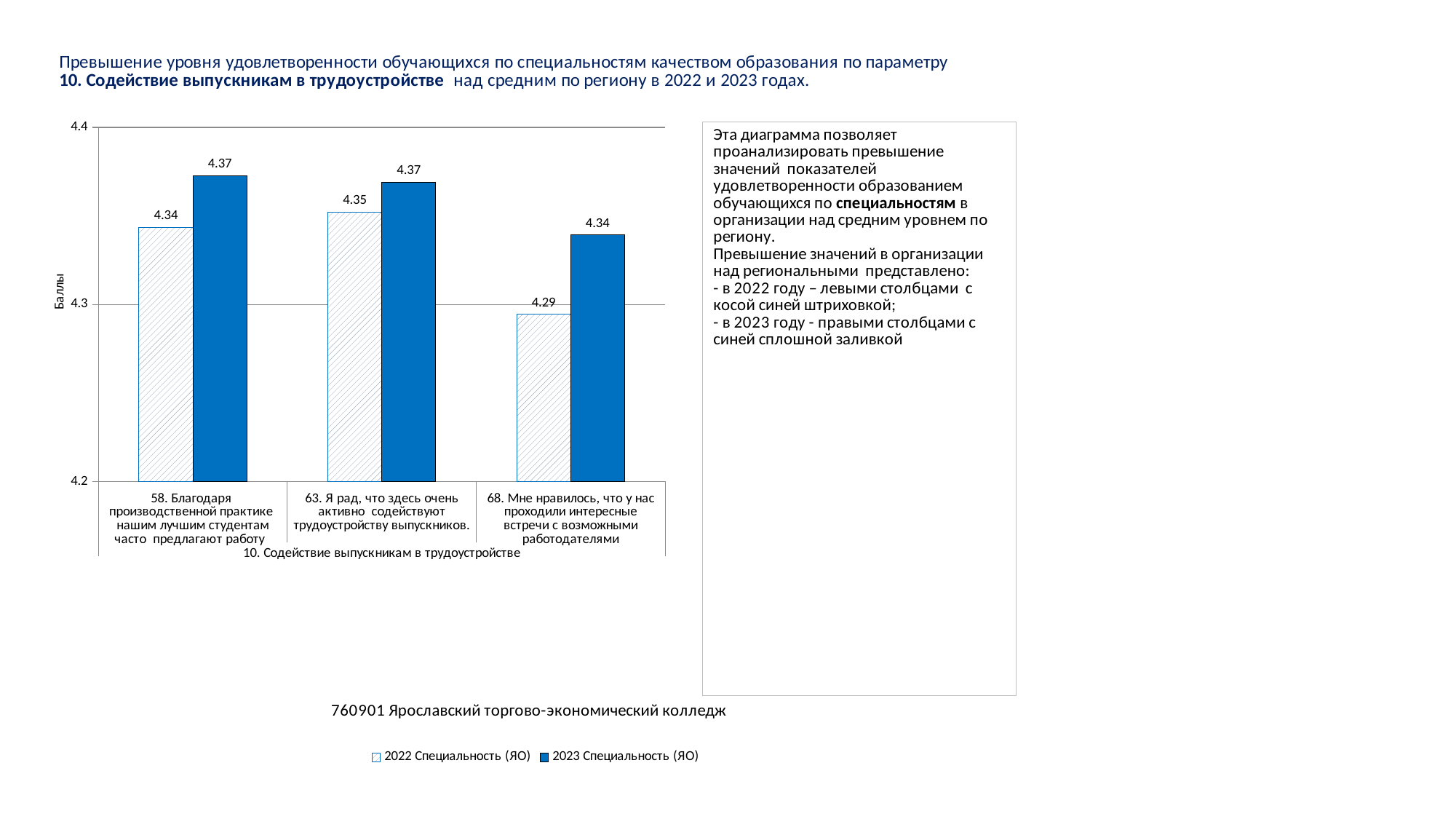
What is the 2022 Специальность (ЯО) value for category 68 (Мне нравилось, что у нас проходили интересные встречи с возможными работодателями)? 4.29 What type of chart is shown on the slide? bar chart What is the 2022 Специальность (ЯО) value for category 63 (Я рад, что здесь очень активно содействуют трудоустройству выпускников)? 4.35 For category 63, which is larger: the 2022 value or the 2023 value? 2023 Is the 2022 value for category 68 greater or less than 4.3? less What is the 2023 Специальность (ЯО) value for category 58 (Благодаря производственной практике нашим лучшим студентам часто предлагают работу)? 4.37 How many categories are shown on the x axis of the chart? 3 How many series does the chart legend list? 2 What is the difference between the 2023 and 2022 values for category 58? 0.03 Which category has the highest 2022 Специальность (ЯО) value? 63. Я рад, что здесь очень активно содействуют трудоустройству выпускников Which category has the lowest 2022 Специальность (ЯО) value? 68. Мне нравилось, что у нас проходили интересные встречи с возможными работодателями What is the difference between the 2023 and 2022 values for category 68? 0.05